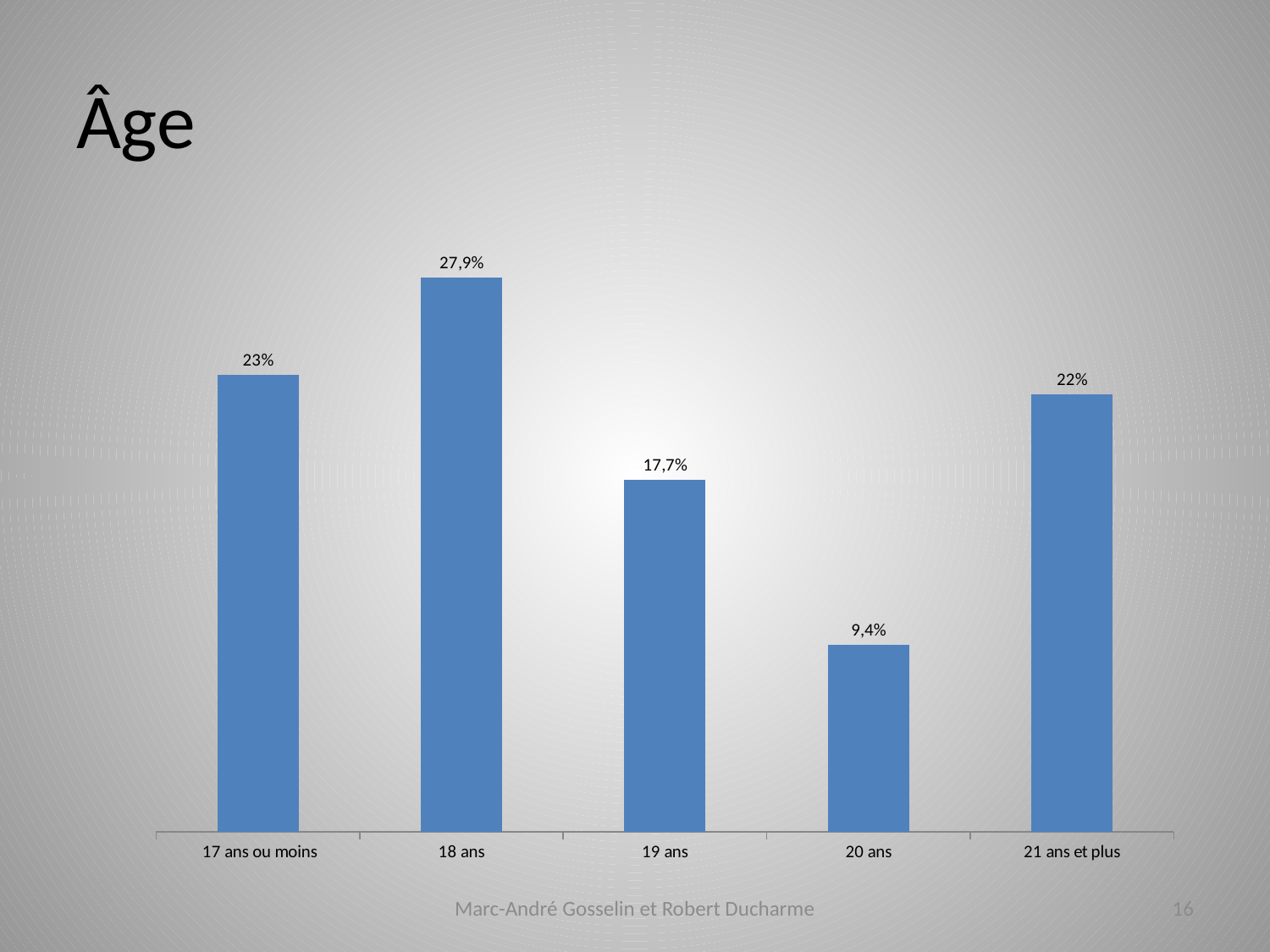
What kind of chart is shown on the slide? Bar chart Which is larger, the value for 19 ans or the value for 21 ans et plus? 21 ans et plus What is the value for 17 ans ou moins? 23% How many age categories are shown in the chart? 5 What is the difference between the values for 18 ans and 20 ans? 18,5% Which age category has the lowest value? 20 ans What is the value for 18 ans? 27,9% Which age category has the highest value? 18 ans What is the title of the slide? Âge What is the difference between the values for 19 ans and 20 ans? 8,3% What is the value for 20 ans? 9,4% What is the value for 21 ans et plus? 22%